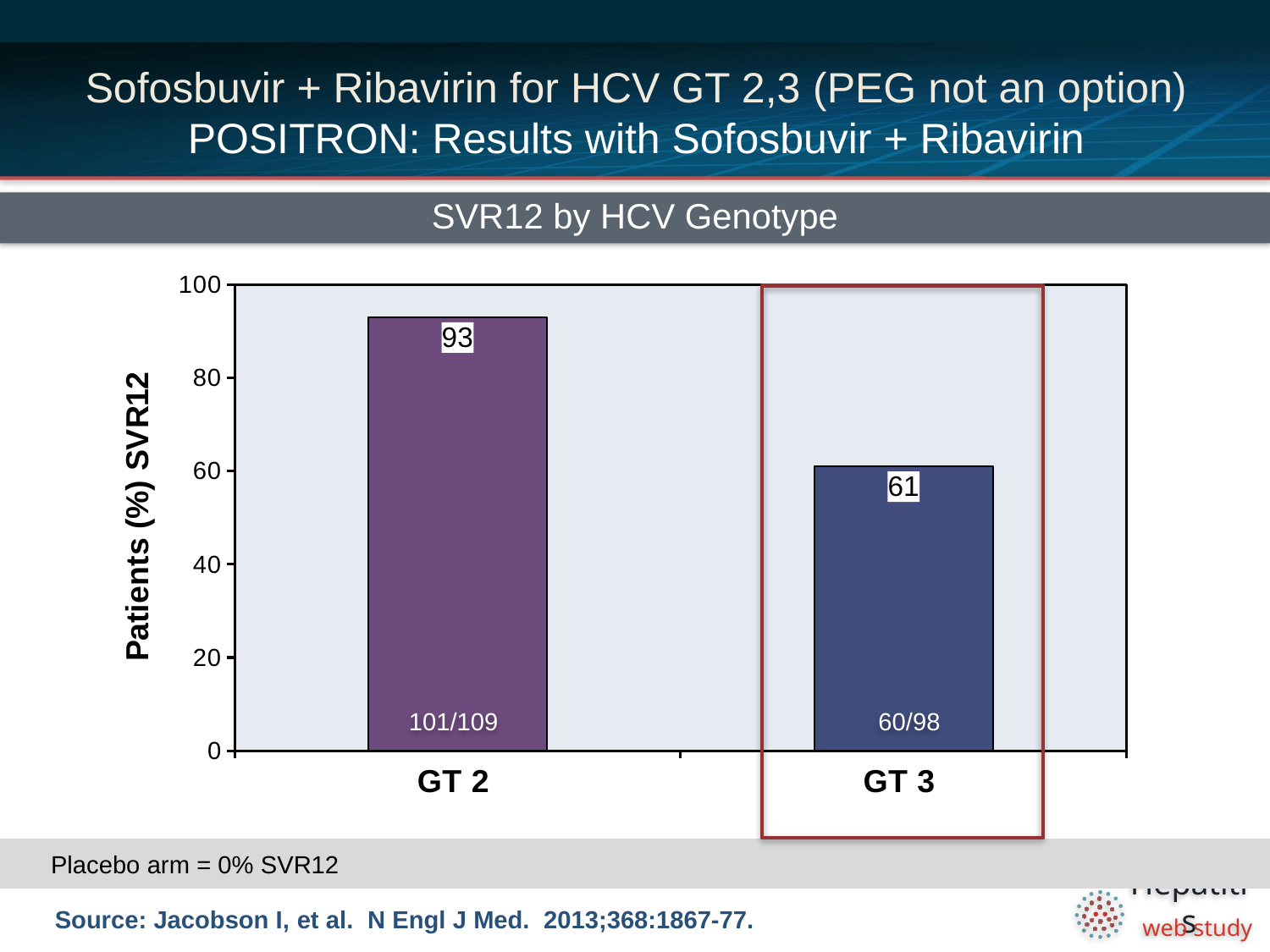
What is the label of the y-axis? Patients (%) SVR12 What is the SVR12 rate (%) for GT 3? 61 What type of chart is shown on the slide? Bar chart Which genotype has the lowest SVR12 rate? GT 3 What is the difference in SVR12 rate (percentage points) between GT 2 and GT 3? 32 What is the SVR12 rate (%) for GT 2? 93 Is the SVR12 rate for GT 3 greater or less than 80? less What fraction of patients (n/N) achieved SVR12 in the GT 2 group? 101/109 Is the SVR12 rate higher for GT 2 or GT 3? GT 2 Which genotype has the highest SVR12 rate? GT 2 What fraction of patients (n/N) achieved SVR12 in the GT 3 group? 60/98 How many genotype categories are shown on the chart? 2